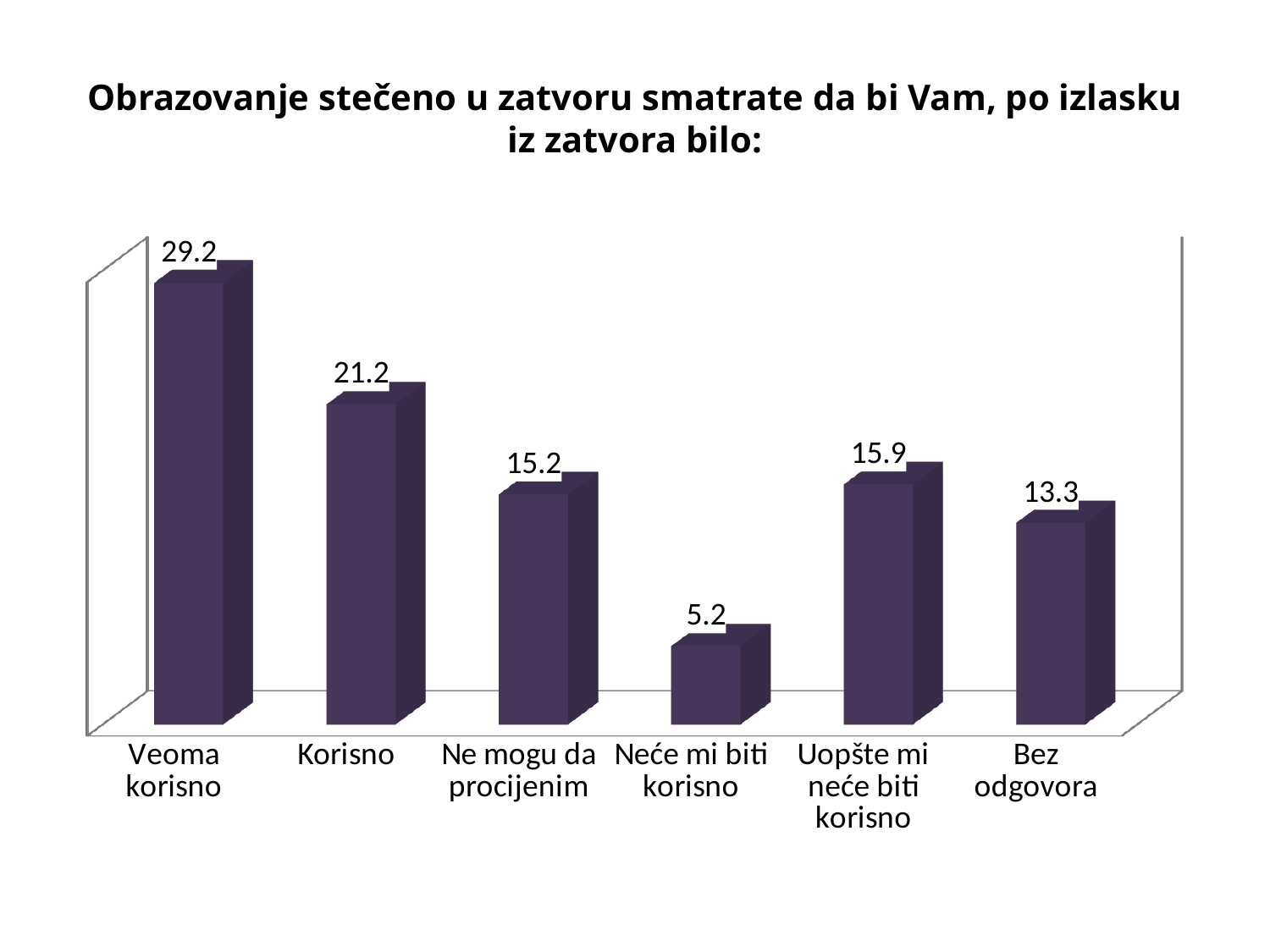
What is the value for "Uopšte mi neće biti korisno"? 15.9 What kind of chart is shown on the slide? Bar chart What is the value for "Veoma korisno"? 29.2 What is the title of the chart? Obrazovanje stečeno u zatvoru smatrate da bi Vam, po izlasku iz zatvora bilo: Which is larger, the value for "Korisno" or the value for "Bez odgovora"? Korisno What is the value for "Neće mi biti korisno"? 5.2 Which category has the lowest value? Neće mi biti korisno What is the difference between the values for "Veoma korisno" and "Korisno"? 8.0 How many categories are shown in the chart? 6 What is the value for "Bez odgovora"? 13.3 What is the difference between the values for "Uopšte mi neće biti korisno" and "Ne mogu da procijenim"? 0.7 Which category has the highest value? Veoma korisno